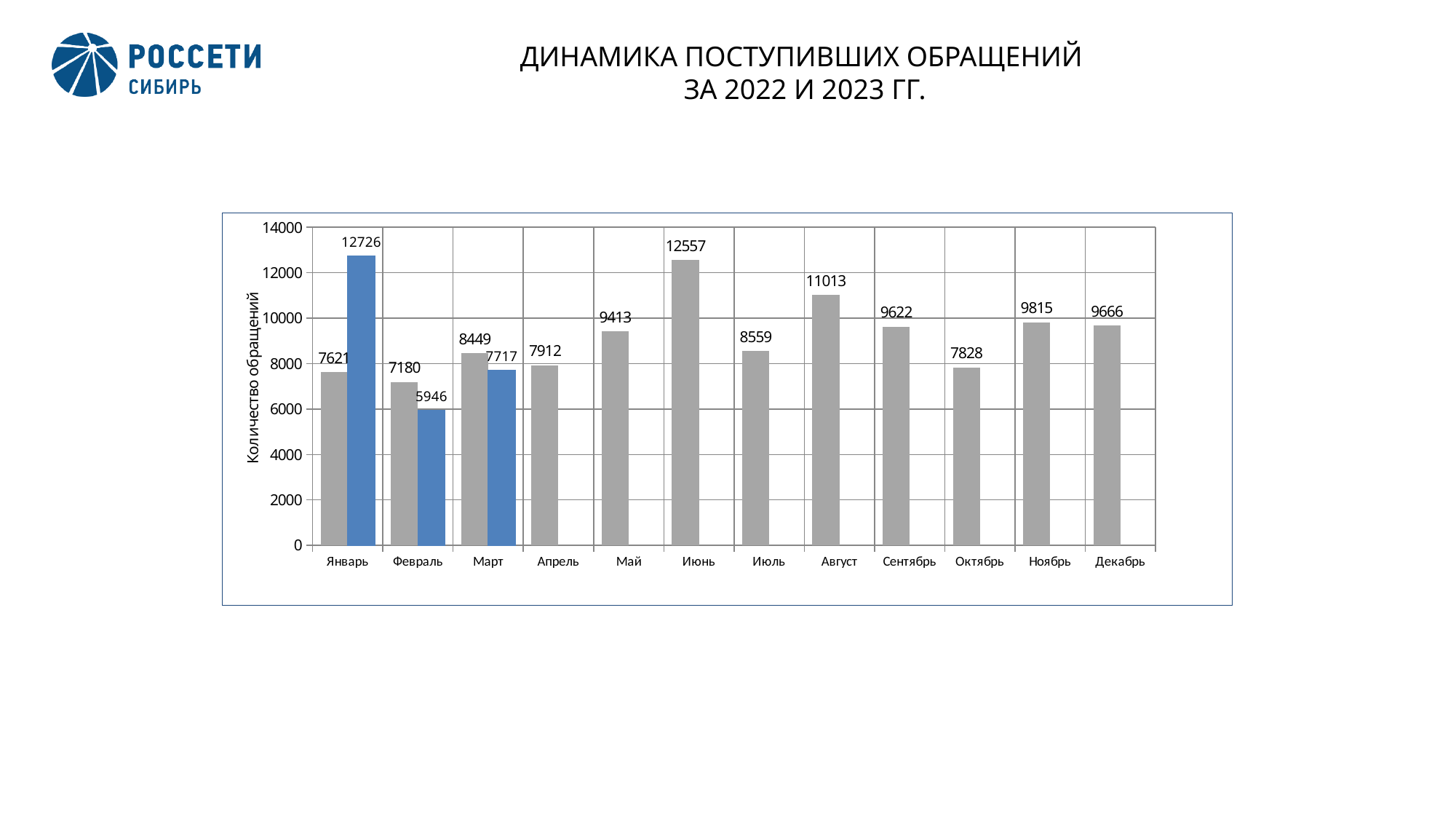
Which month has the highest grey bar? Июнь What is the value of the blue bar for Январь? 12726 What is the value of the blue bar for Февраль? 5946 What is the value of the grey bar for Июнь? 12557 What kind of chart is shown on the slide? Bar chart Which month has the lowest grey bar? Февраль What is the difference between the grey bar and the blue bar for Март? 732 How many months are shown on the x axis? 12 What is the label of the vertical axis? Количество обращений What is the difference between the blue bar and the grey bar for Январь? 5105 What is the value of the grey bar for Октябрь? 7828 Which is larger, the grey bar for Август or the grey bar for Сентябрь? Август